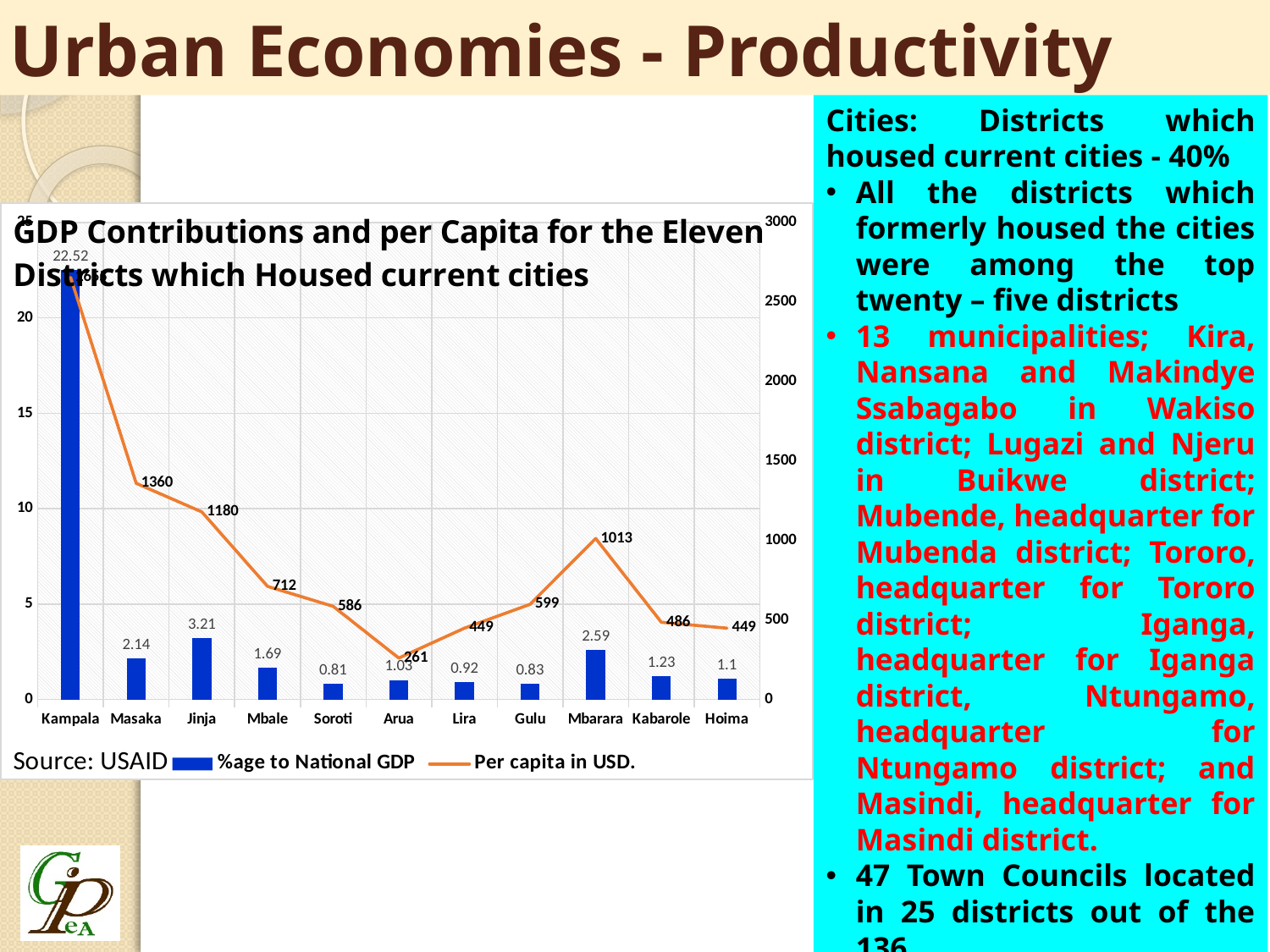
What is the difference in Per capita in USD between Masaka and Jinja? 180 What is the Per capita in USD value for Mbarara? 1013 Is the Per capita in USD value for Kampala greater or less than 2500? greater Which district has the highest %age to National GDP? Kampala What is the source cited for the chart? USAID What is the Per capita in USD value for Masaka? 1360 How many districts are shown on the x axis? 11 Which has a higher %age to National GDP, Mbarara or Masaka? Mbarara What is the %age to National GDP for Jinja? 3.21 Which district has the lowest Per capita in USD? Arua Which district has the lowest %age to National GDP? Soroti How many series does the legend list? 2